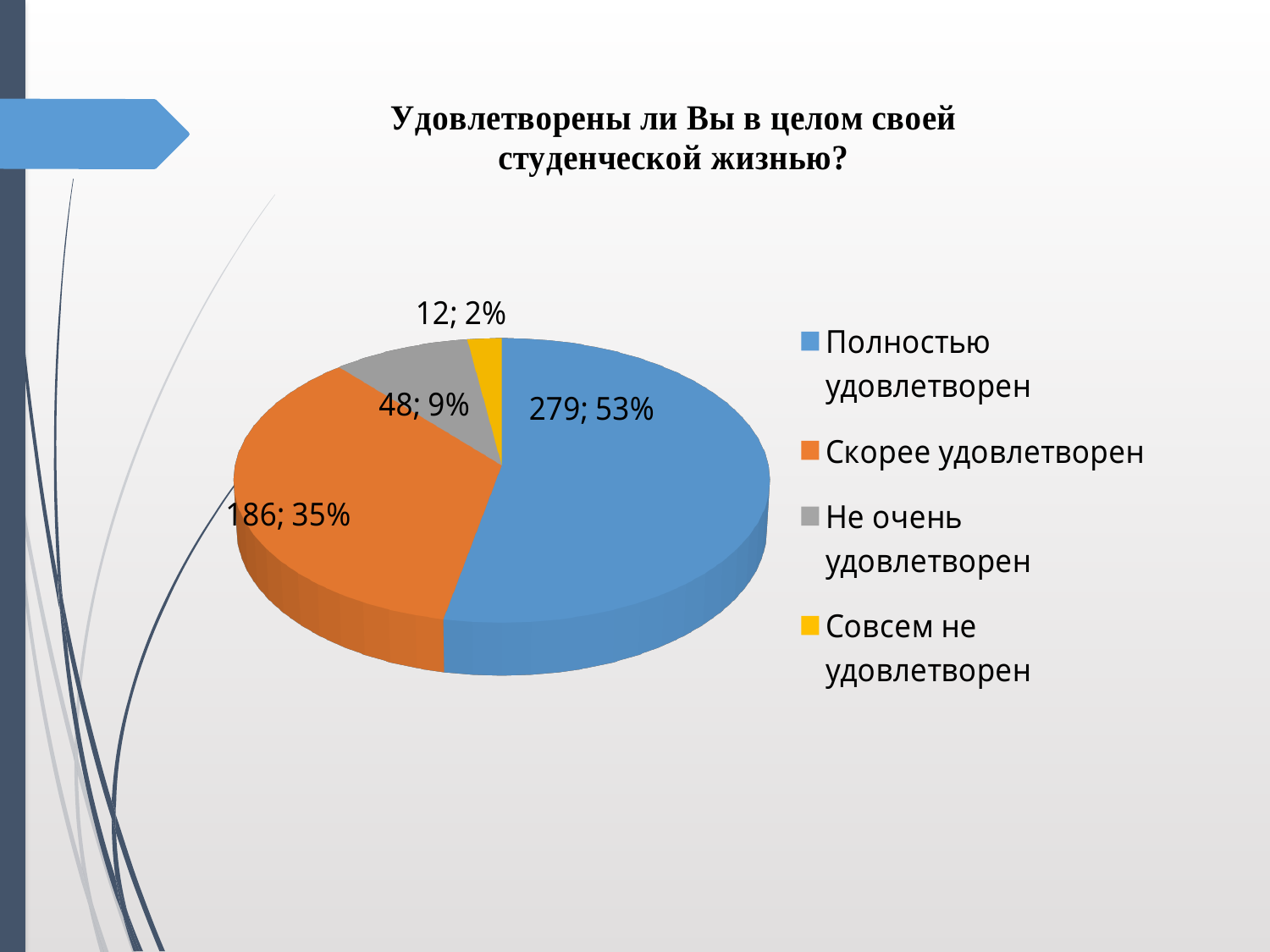
What is the count for "Не очень удовлетворен"? 48 How many entries does the legend list? 4 What is the count for "Полностью удовлетворен"? 279 What is the difference between the counts for "Полностью удовлетворен" and "Скорее удовлетворен"? 93 What is the count for "Скорее удовлетворен"? 186 Which category has the smallest slice? Совсем не удовлетворен What share of the pie does "Скорее удовлетворен" take? 35% How many slices does the pie chart have? 4 Which category has the largest slice? Полностью удовлетворен What kind of chart is shown on the slide? pie chart What is the count for "Совсем не удовлетворен"? 12 What is the title of the chart? Удовлетворены ли Вы в целом своей студенческой жизнью?